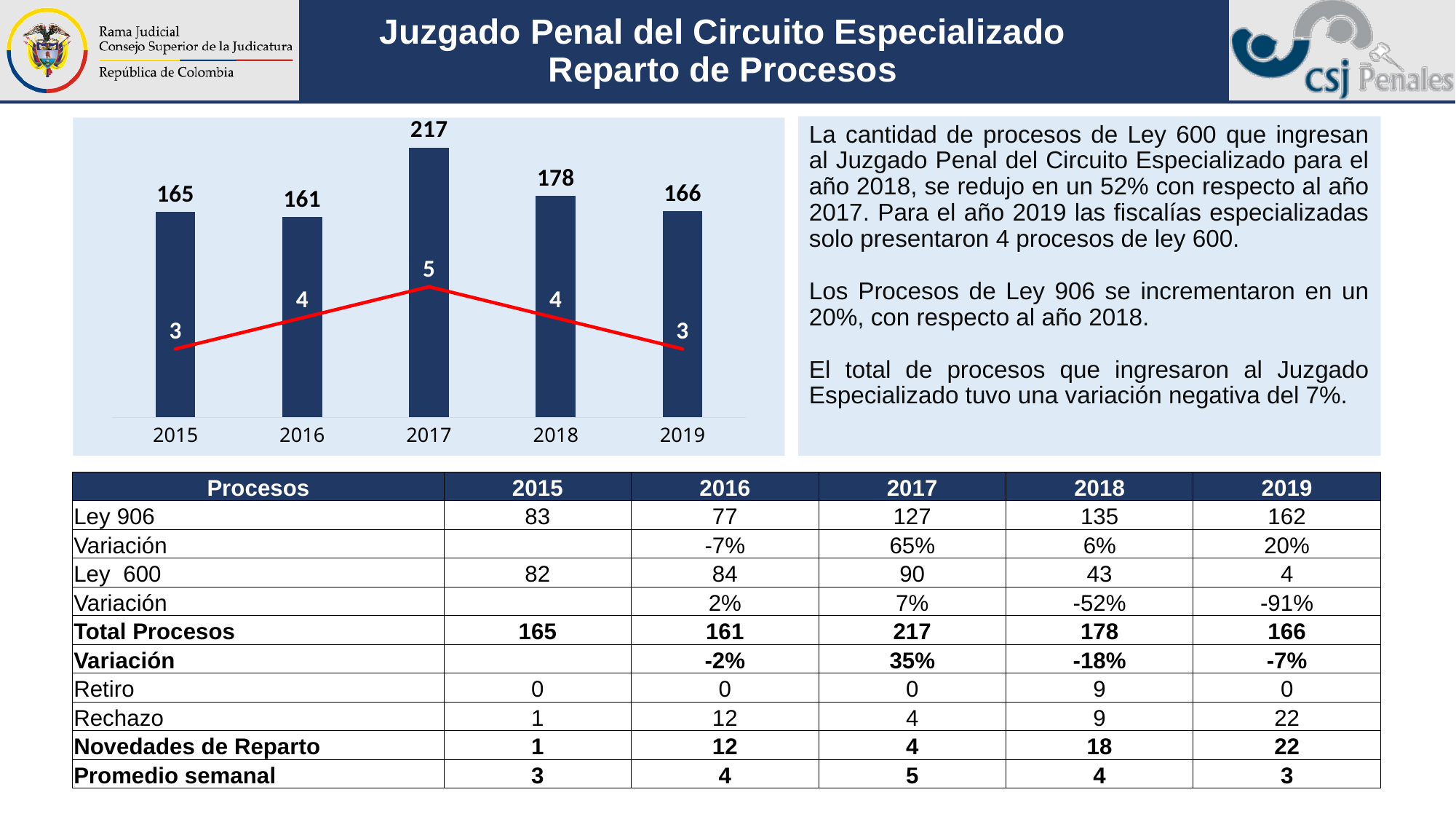
What type of chart is shown on the slide? Bar chart with a line Does the red line rise or fall from 2017 to 2019 in the chart? Fall What is the value of the bar for 2015 in the chart? 165 What is the difference between the bar values for 2017 and 2018 in the chart? 39 What value does the red line show for 2017 in the chart? 5 What colour is the line plotted over the bars in the chart? Red Which year has the lowest bar in the chart? 2016 Which year has the highest bar in the chart? 2017 What is the value of the bar for 2017 in the chart? 217 What value does the red line show for 2019 in the chart? 3 How many years are shown on the x axis of the chart? 5 Which bar is larger in the chart, 2018 or 2019? 2018